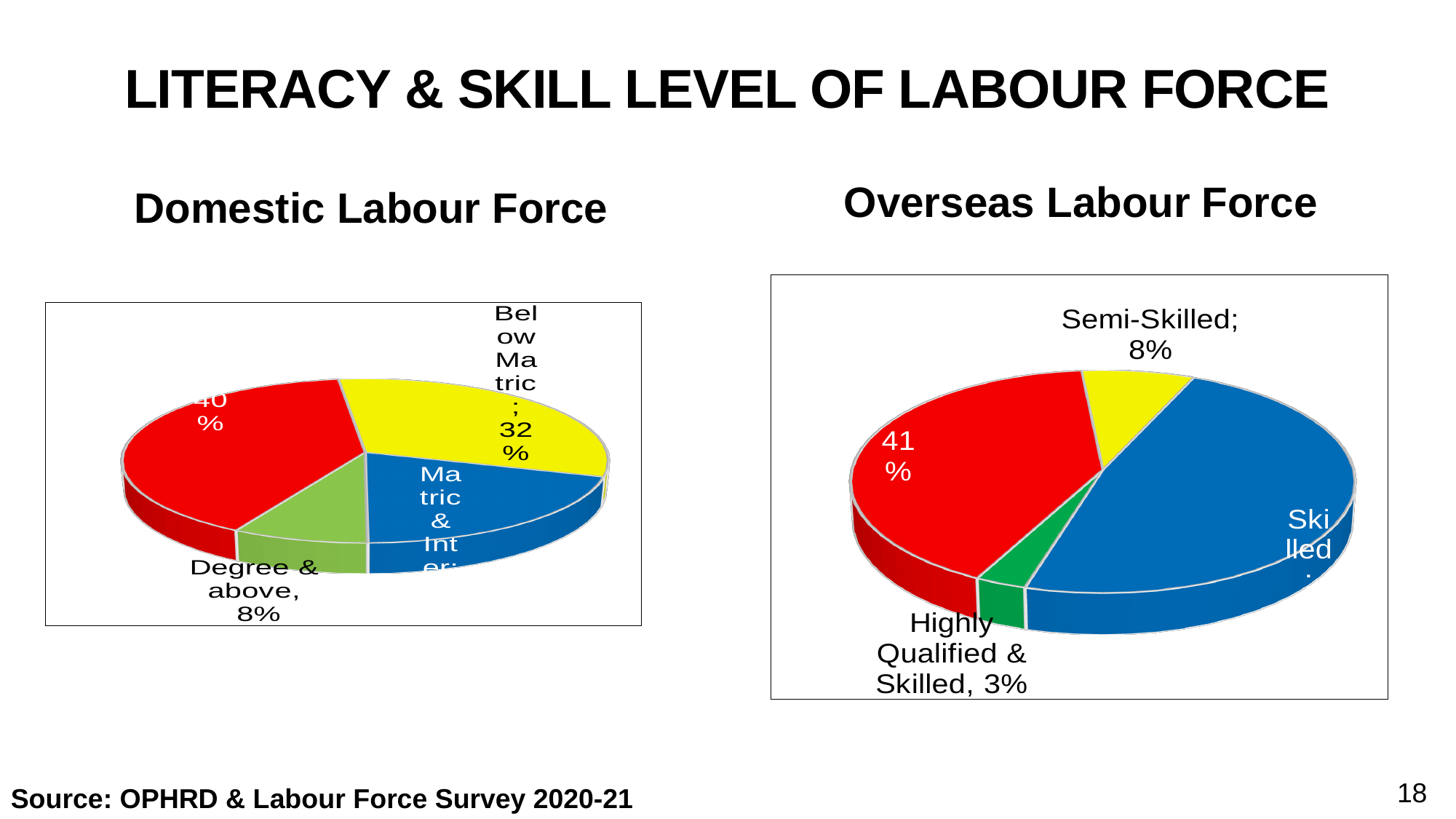
In the Overseas Labour Force chart, which is larger: Semi-Skilled or Highly Qualified & Skilled? Semi-Skilled In the Domestic Labour Force chart, what colour is the Below Matric slice? Yellow In the Domestic Labour Force chart, which category has the smallest slice? Degree & above In the Domestic Labour Force chart, what share is labelled for Degree & above? 8% How many slices does the Overseas Labour Force pie chart have? 4 In the Overseas Labour Force chart, what is the difference in percentage points between Semi-Skilled and Highly Qualified & Skilled? 5 percentage points In the Overseas Labour Force chart, which category has the smallest slice? Highly Qualified & Skilled What kind of chart is the Domestic Labour Force chart? Pie chart In the Overseas Labour Force chart, what share is labelled for Semi-Skilled? 8% In the Domestic Labour Force chart, what is the difference in percentage points between Below Matric and Degree & above? 24 percentage points In the Domestic Labour Force chart, what share is labelled for Below Matric? 32% In the Overseas Labour Force chart, what share is labelled for Highly Qualified & Skilled? 3%